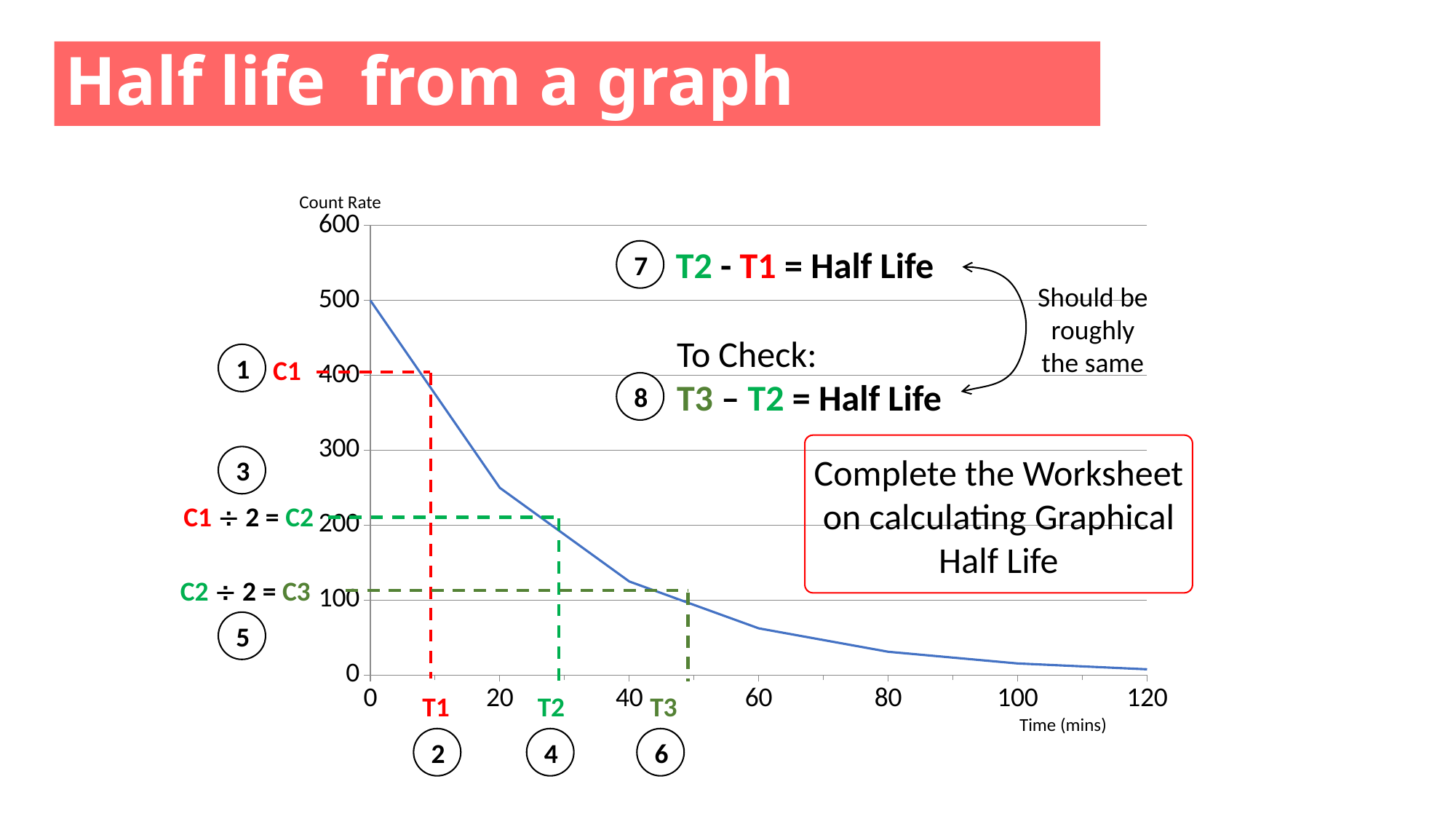
Is the count rate at 120 mins greater or less than 100? less What is the label of the x axis? Time (mins) Is the count rate at 20 mins greater or less than 200? greater Is the count rate at 40 mins greater or less than 100? greater What is the label of the y axis? Count Rate What kind of chart is shown on the slide? line chart At which time shown on the x axis is the count rate highest? 0 Does the count rate rise or fall as time increases along the x axis? fall What is the count rate at time 0 mins? 500 Which is larger, the count rate at 20 mins or the count rate at 60 mins? 20 mins